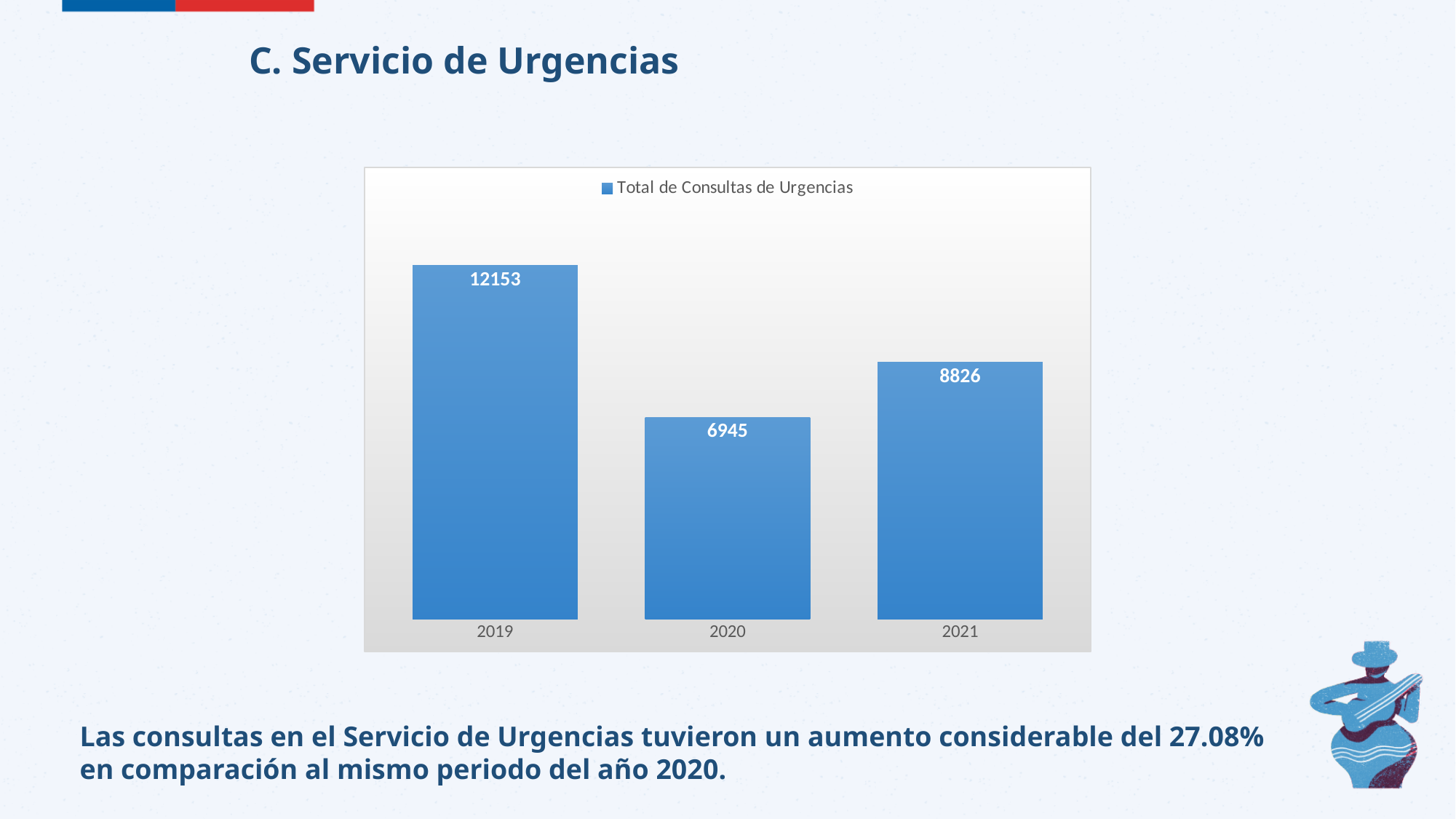
What is the difference between the values for 2021 and 2020? 1881 Which year has the lowest value? 2020 What is the name of the series in the legend? Total de Consultas de Urgencias How many years are shown on the x axis? 3 What is the value for 2021? 8826 Which year has the highest value? 2019 Which is larger, the value for 2021 or the value for 2020? 2021 How many series does the legend list? 1 What is the value for 2020? 6945 What kind of chart is shown? bar chart What is the difference between the values for 2019 and 2020? 5208 What is the value for 2019? 12153